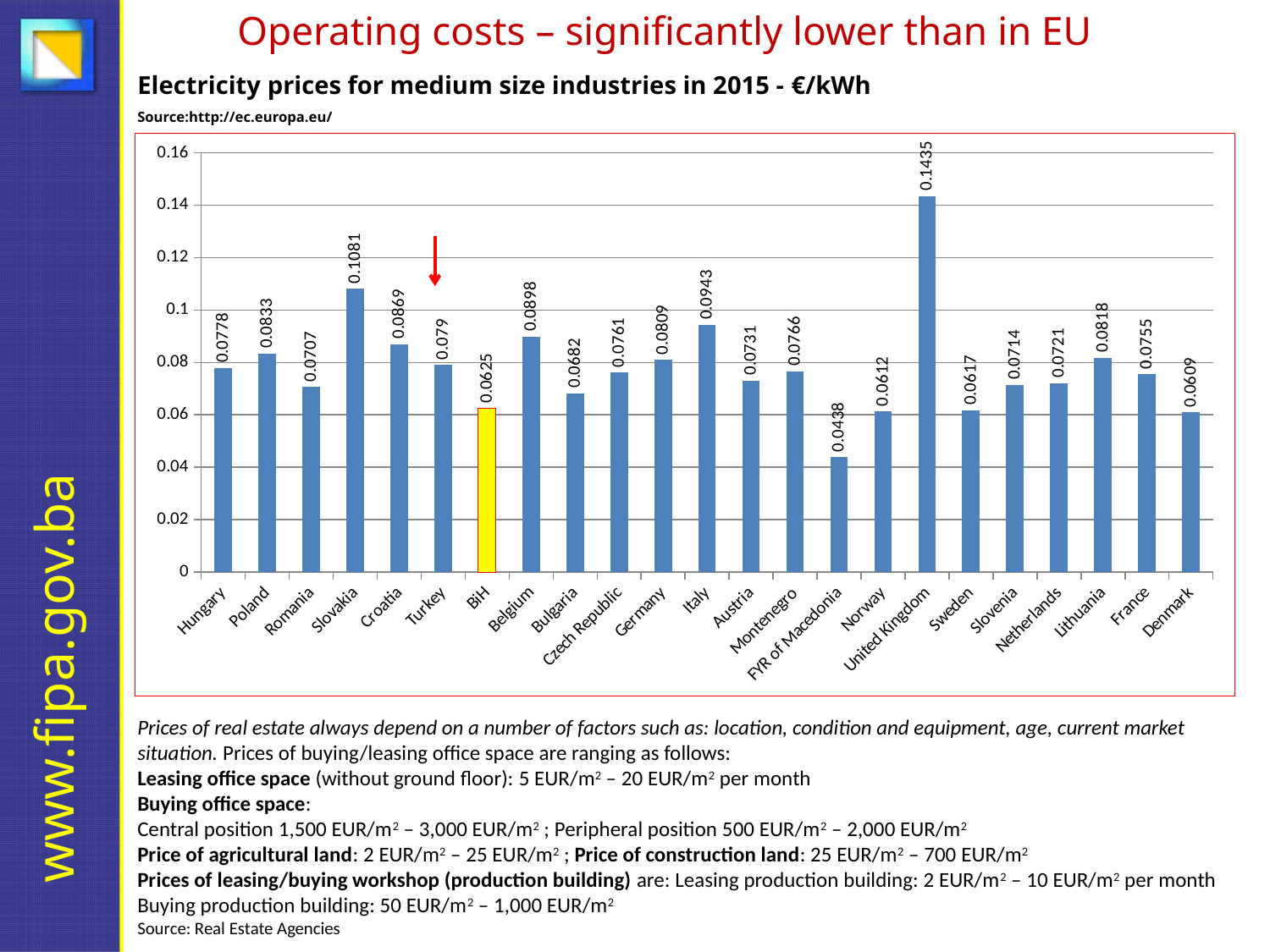
What is the difference between the electricity price for Slovakia and for BiH? 0.0456 What is the electricity price for Slovakia? 0.1081 How many countries are shown in the chart? 23 Which country has the highest electricity price in the chart? United Kingdom What is the difference between the electricity price for the United Kingdom and for BiH? 0.081 What is the electricity price for BiH? 0.0625 Is the value for Slovakia greater or less than 0.1? greater What is the electricity price for Germany? 0.0809 Which has a higher electricity price, Italy or Belgium? Italy What kind of chart is shown on the slide? Bar chart Which country's bar is highlighted in yellow? BiH Which country has the lowest electricity price in the chart? FYR of Macedonia